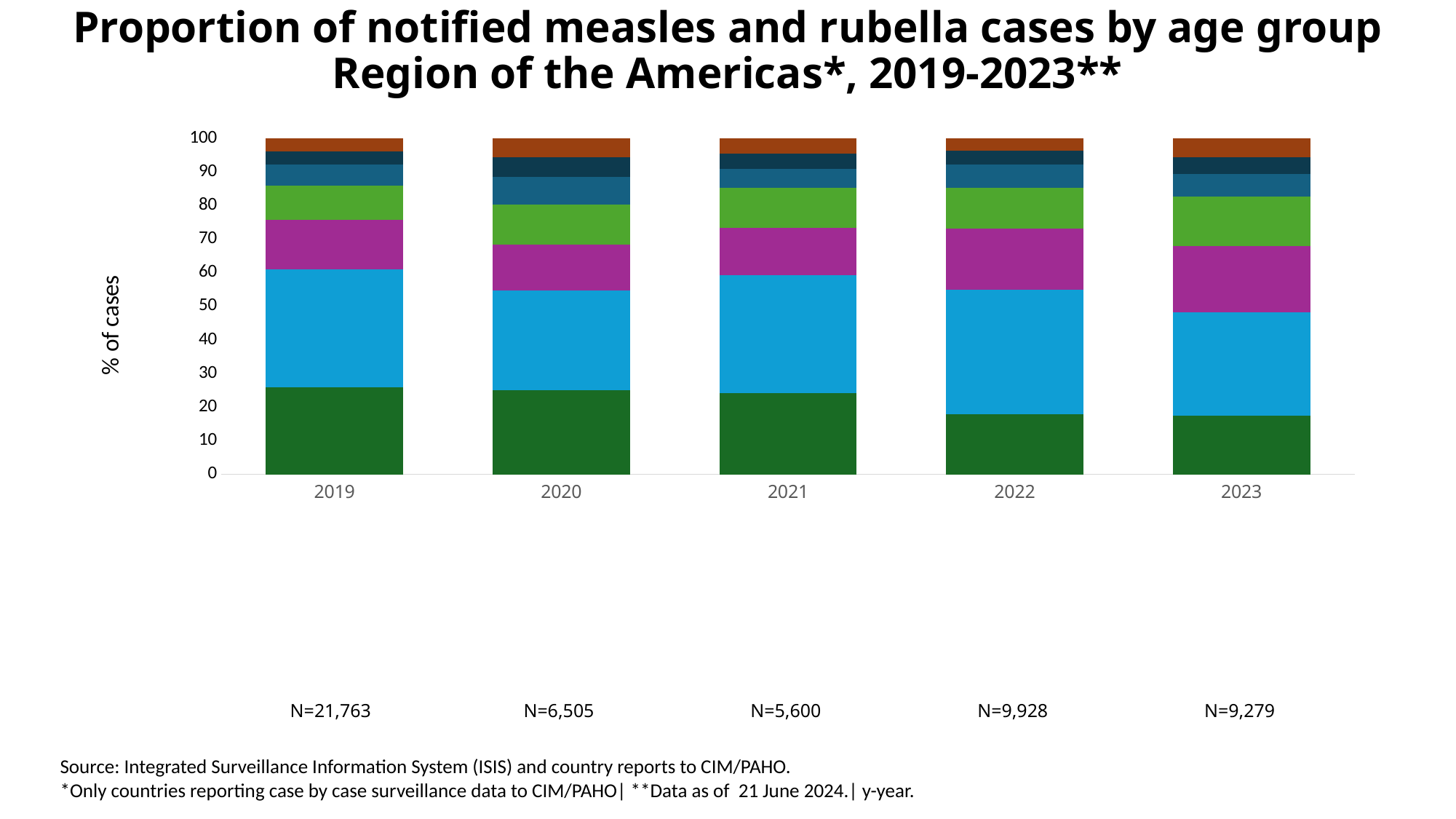
What is the N value printed below the 2021 bar? N=5,600 What is the label on the y axis of the chart? % of cases What is the title of the chart? Proportion of notified measles and rubella cases by age group Region of the Americas*, 2019-2023** What is the difference between the N values for 2022 and 2023? 649 What is the N value printed below the 2019 bar? N=21,763 Which year has the largest N value printed below its bar? 2019 Which year has a larger N value, 2020 or 2022? 2022 What is the total height of the stacked bar for 2019 on the y axis? 100 Is the top of the bottom dark green segment for 2023 greater or less than 20? less What kind of chart is shown on the slide? Stacked bar chart Which year has the smallest N value printed below its bar? 2021 How many years are shown on the x axis of the chart? 5